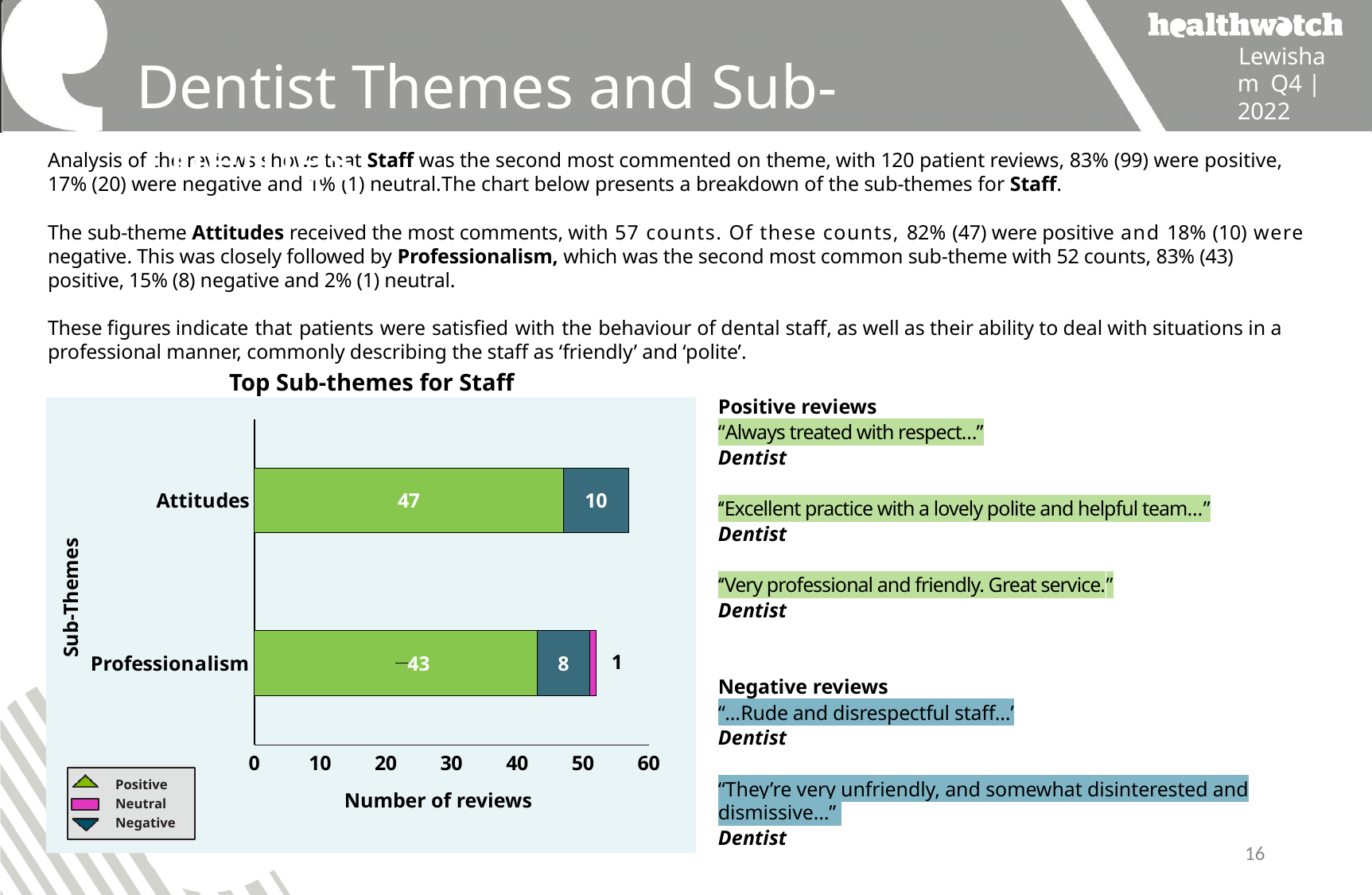
What is the total number of reviews in the Attitudes bar? 57 What is the difference between the positive reviews for Attitudes and for Professionalism? 4 What is the label of the x axis? Number of reviews How many sub-themes are plotted in the chart? 2 How many series does the legend list? 3 How many negative reviews are shown for Professionalism? 8 How many neutral reviews are shown for Professionalism? 1 What type of chart is 'Top Sub-themes for Staff'? Stacked bar chart Which sub-theme has more negative reviews, Attitudes or Professionalism? Attitudes What is the total number of reviews in the Professionalism bar? 52 How many negative reviews are shown for Attitudes? 10 How many positive reviews are shown for Attitudes? 47